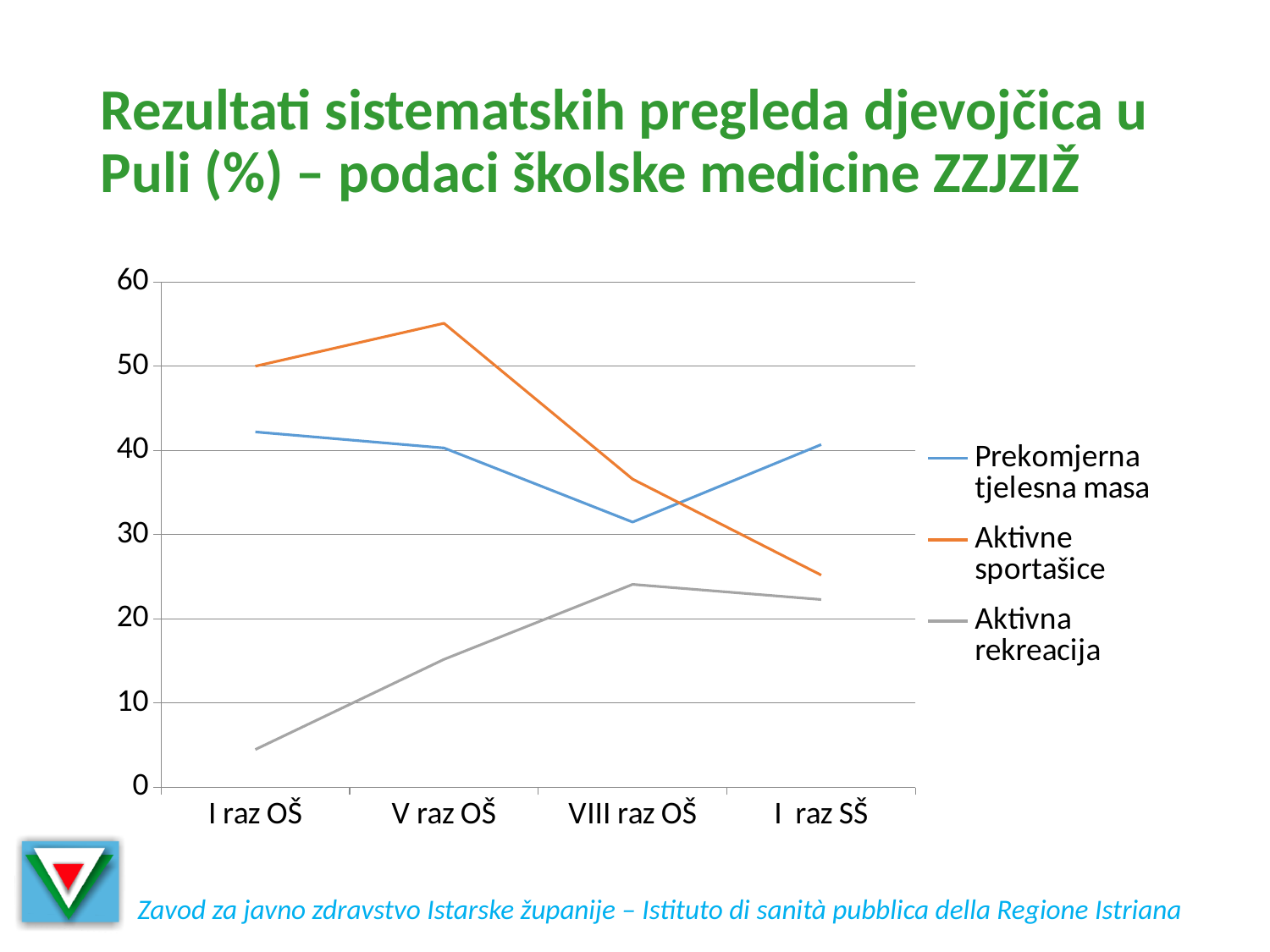
Which category has the highest value for Aktivne sportašice? V raz OŠ How many series does the legend list? 3 Does the Aktivne sportašice line rise or fall from V raz OŠ to I raz SŠ? fall Is the value for Aktivna rekreacija at I raz OŠ greater or less than 10? less Is the value for Aktivne sportašice at V raz OŠ greater or less than 50? greater How many categories are shown on the x axis? 4 Which category has the lowest value for Aktivna rekreacija? I raz OŠ What kind of chart is shown on the slide? line chart Which series is drawn in orange? Aktivne sportašice Which category has the lowest value for Prekomjerna tjelesna masa? VIII raz OŠ At I raz OŠ, which series has the larger value: Prekomjerna tjelesna masa or Aktivne sportašice? Aktivne sportašice